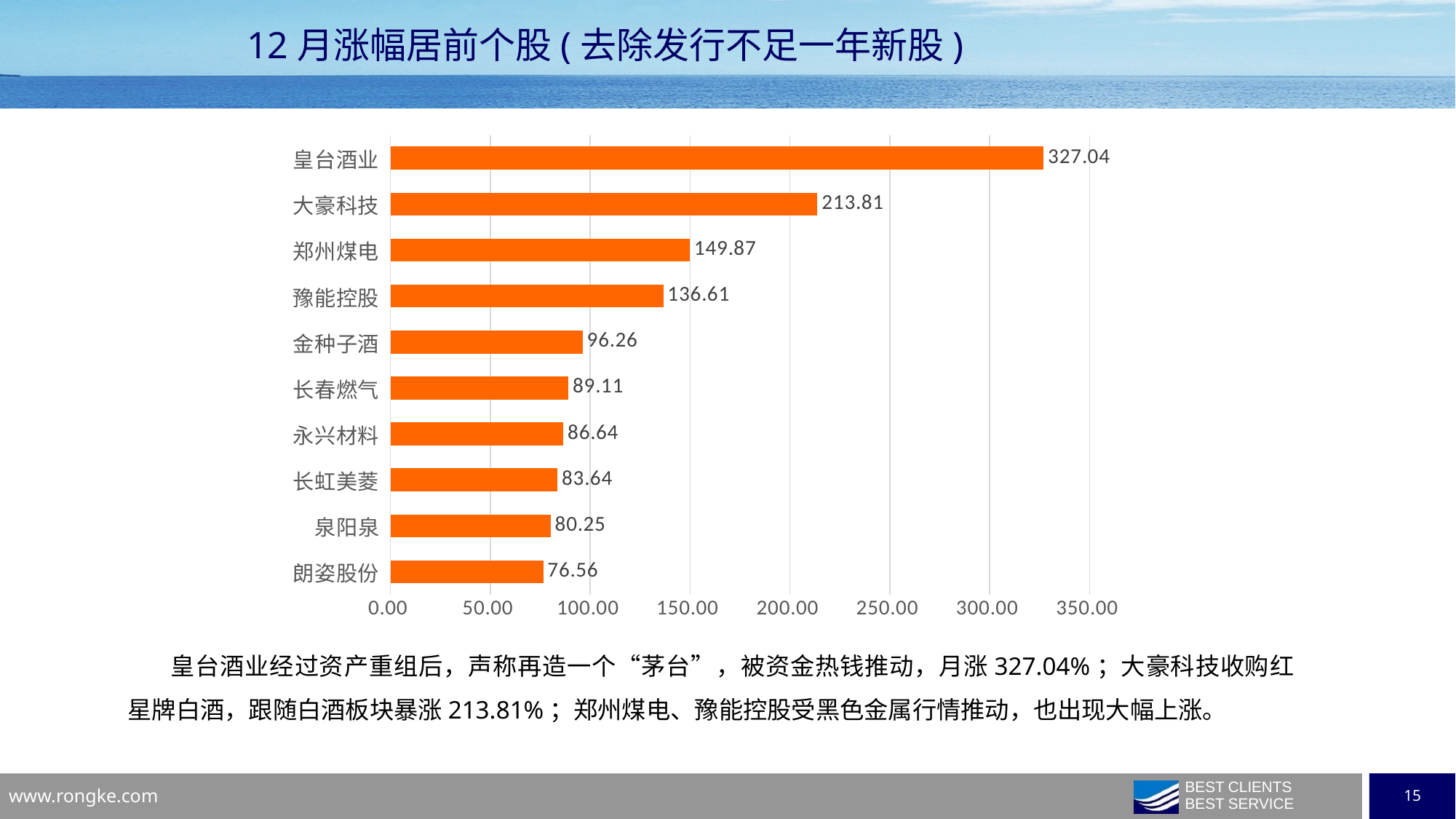
What colour are the bars in the chart? orange What is the value for 郑州煤电? 149.87 Which stock has the highest value in the chart? 皇台酒业 Is the value for 大豪科技 greater or less than 200.00? greater How many stocks are shown in the chart? 10 What is the difference between the values for 郑州煤电 and 豫能控股? 13.26 What kind of chart is shown on the slide? bar chart What is the difference between the values for 皇台酒业 and 大豪科技? 113.23 Which has a larger value, 金种子酒 or 长春燃气? 金种子酒 Which stock has the lowest value in the chart? 朗姿股份 What is the value for 皇台酒业? 327.04 What is the value for 长虹美菱? 83.64